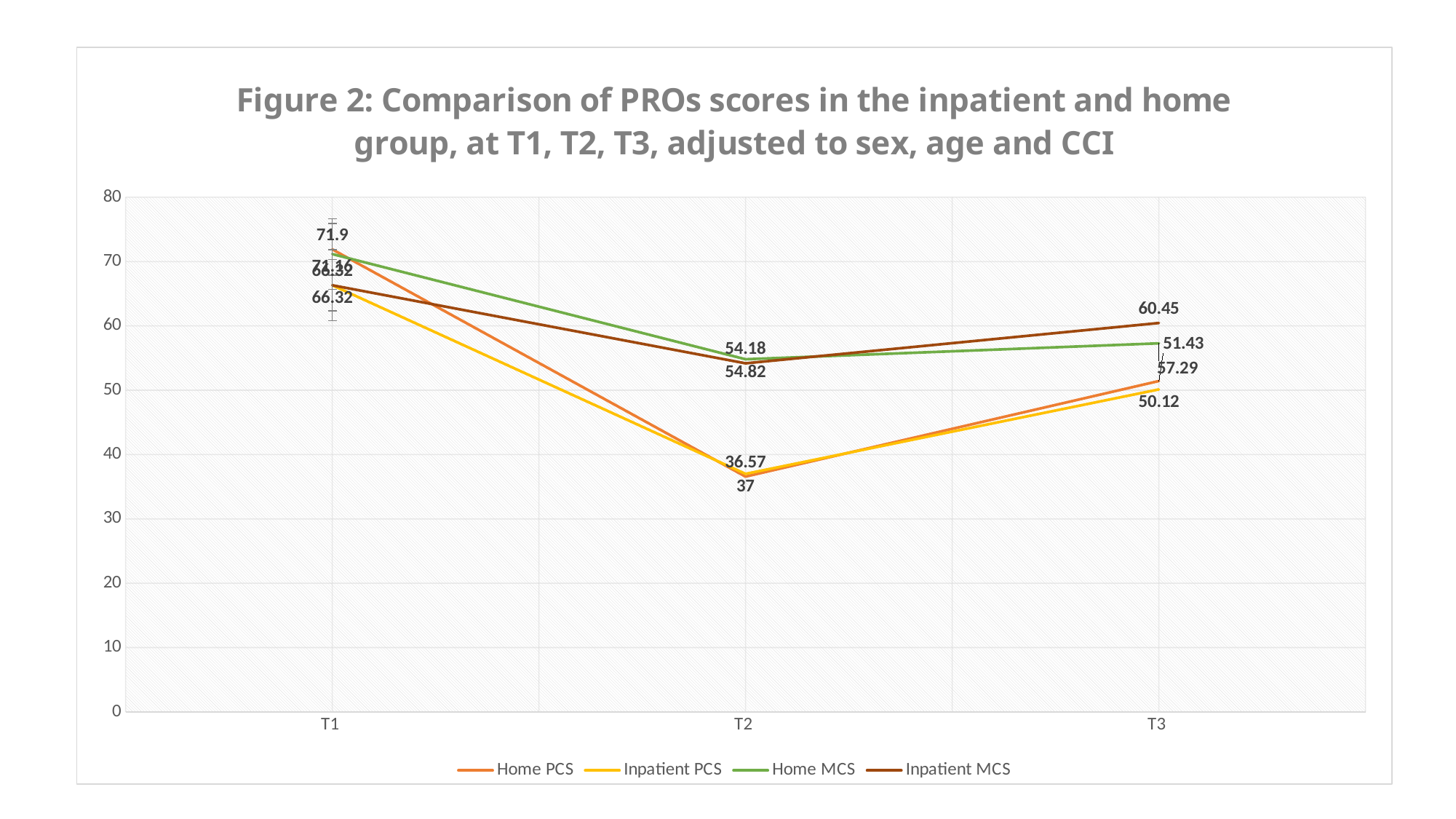
What is the value for Inpatient MCS at T3? 60.45 What is the value for Inpatient PCS at T3? 50.12 What is the value for Home PCS at T3? 51.43 What kind of chart is shown on the slide? Line chart Which series has the lowest value at T3? Inpatient PCS What is the difference between Inpatient MCS and Home MCS at T3? 3.16 Does the Home PCS line rise or fall from T1 to T2? Fall Is the value for Home PCS at T2 greater or less than 40? less How many time points are shown on the x axis? 3 Which series has the highest value at T3? Inpatient MCS What is the value for Home MCS at T3? 57.29 How many series does the legend list? 4